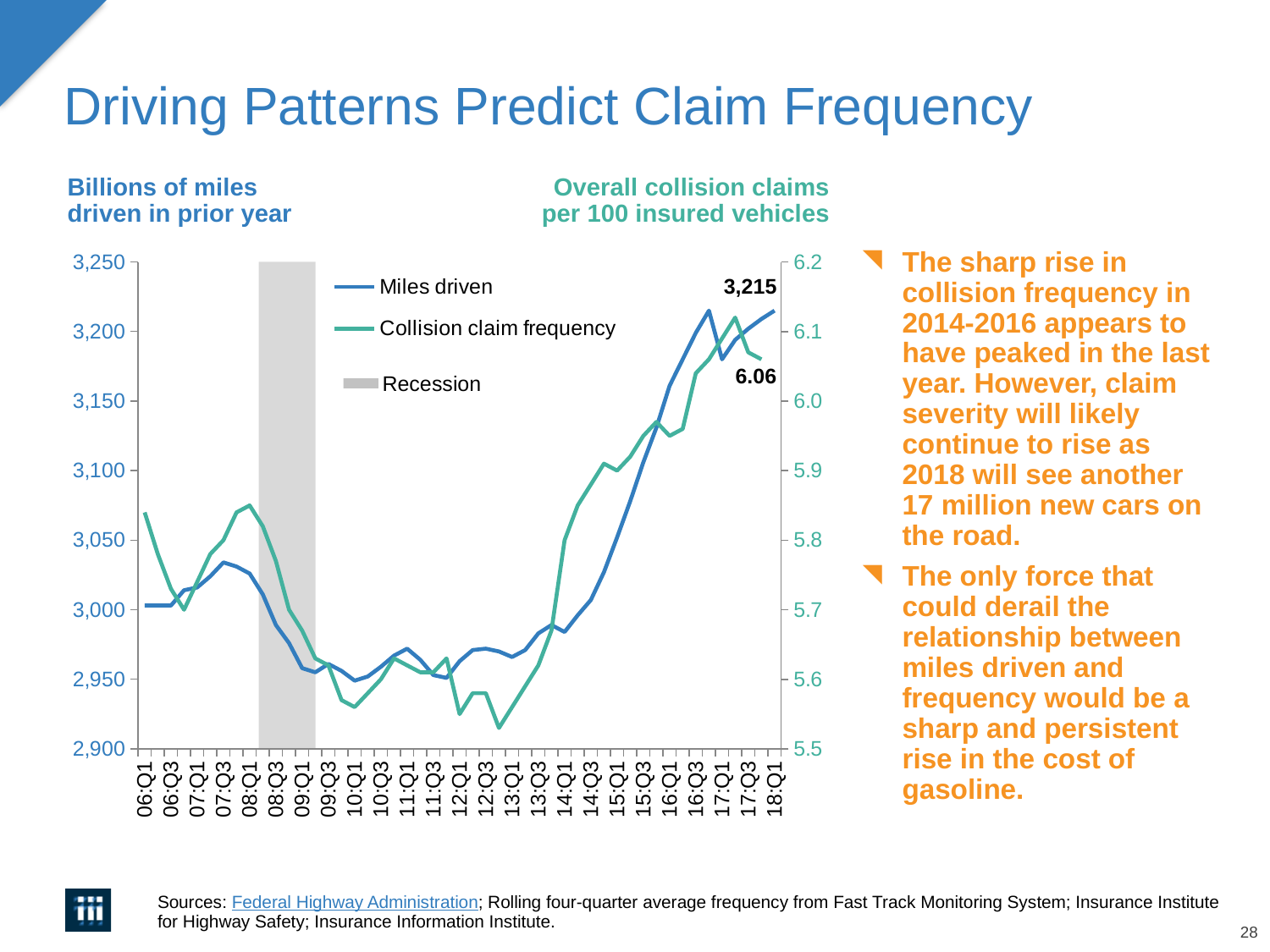
In which quarter is the Collision claim frequency at its lowest? 12:Q4 What is the value of Miles driven at 18:Q1? 3,215 Is the Collision claim frequency at 08:Q1 greater or less than 5.7? greater What does the grey shaded area on the chart represent? Recession Is the value for Miles driven at 16:Q3 greater or less than 3,150? greater How many entries does the chart legend list? 3 Does the Miles driven line rise or fall between 14:Q1 and 16:Q3? rise Is the Collision claim frequency at 12:Q3 greater or less than 5.6? less What kind of chart is shown on the slide? line chart